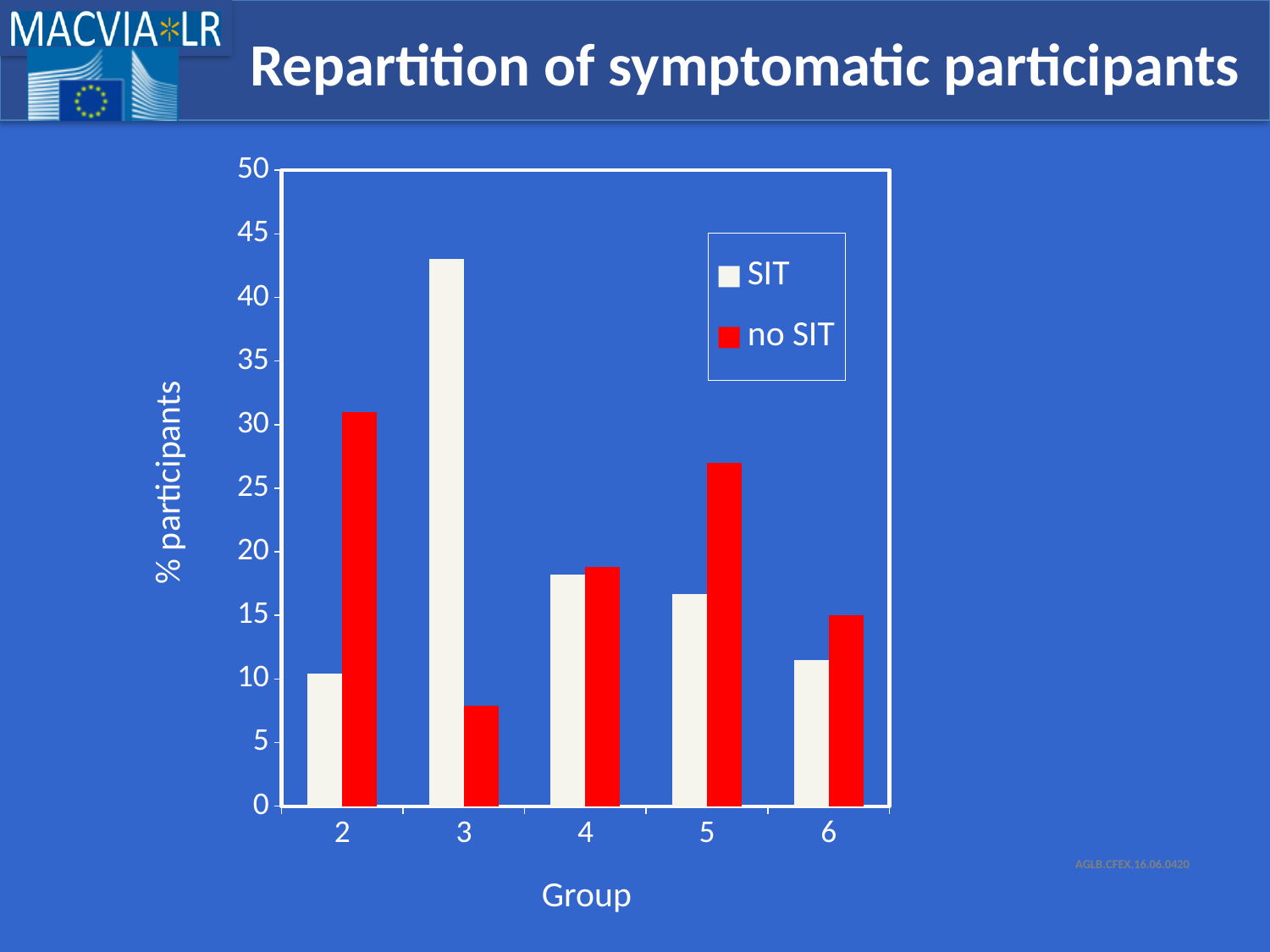
In Group 2, which is larger, SIT or no SIT? no SIT Is the no SIT value for Group 3 greater or less than 10? less What is the label of the y axis? % participants Is the SIT value for Group 3 greater or less than 40? greater Which group has the highest no SIT value? Group 2 What colour represents the no SIT series? red What kind of chart is shown on the slide? bar chart In Group 5, which is larger, SIT or no SIT? no SIT Which group has the lowest no SIT value? Group 3 How many groups are shown on the x axis? 5 How many series does the legend list? 2 Which group has the highest SIT value? Group 3